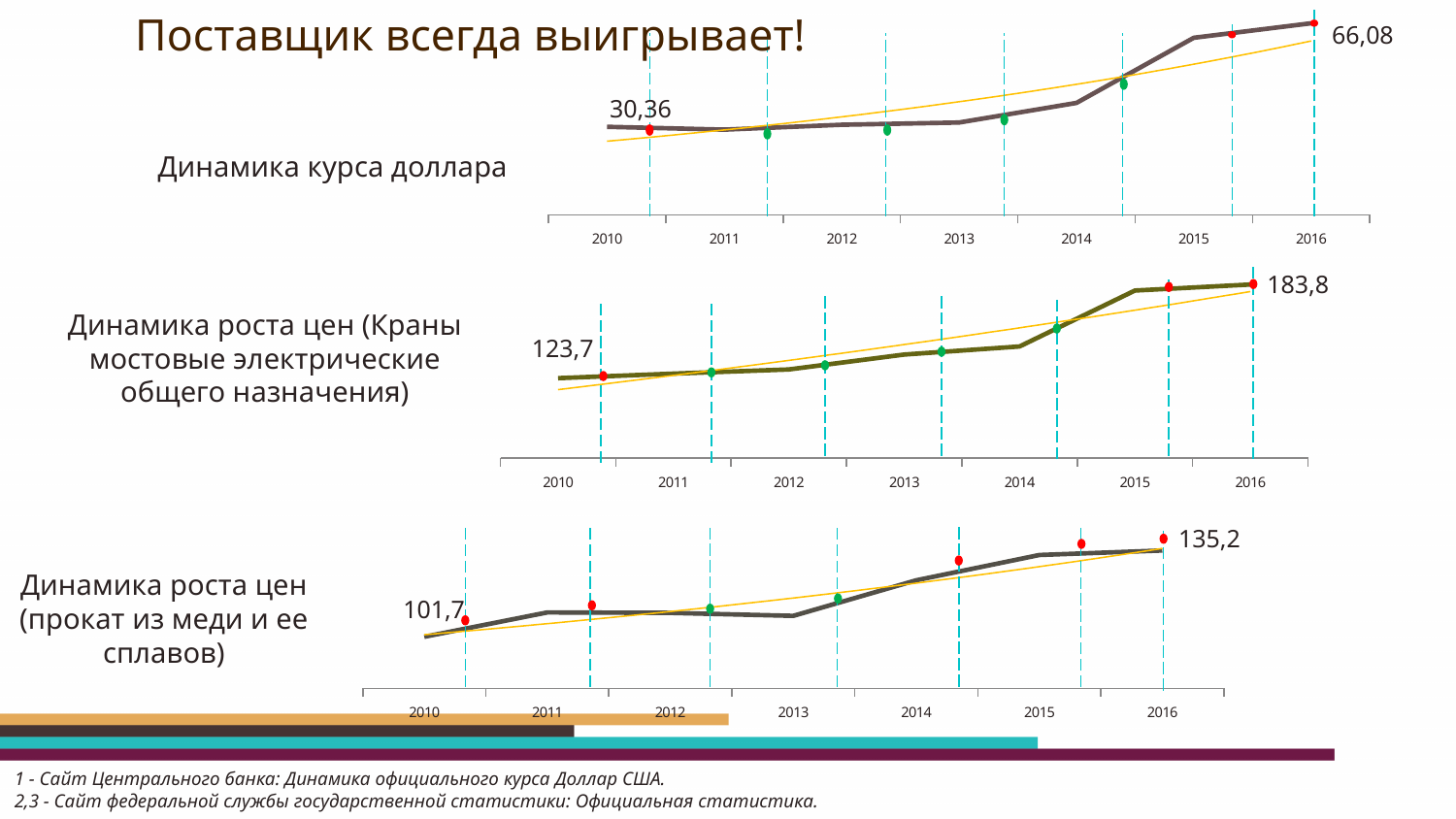
In the chart 'Динамика роста цен (прокат из меди и ее сплавов)', what value is labelled for 2016? 135,2 How many years are shown on the x axis of the chart 'Динамика роста цен (прокат из меди и ее сплавов)'? 7 In the chart 'Динамика роста цен (прокат из меди и ее сплавов)', what is the difference between the 2016 and 2010 values? 33,5 In the chart 'Динамика роста цен (Краны мостовые электрические общего назначения)', what value is labelled for 2010? 123,7 What kind of chart is 'Динамика курса доллара'? Line chart In the chart 'Динамика курса доллара', what value is labelled for 2010? 30,36 In the chart 'Динамика курса доллара', do the values rise or fall from 2010 to 2016? Rise In the chart 'Динамика курса доллара', by how much does the 2016 value exceed the 2010 value? 35,72 In the chart 'Динамика роста цен (Краны мостовые электрические общего назначения)', what is the difference between the 2016 and 2010 values? 60,1 In the chart 'Динамика роста цен (прокат из меди и ее сплавов)', what value is labelled for 2010? 101,7 In the chart 'Динамика курса доллара', what value is labelled for 2016? 66,08 In the chart 'Динамика роста цен (Краны мостовые электрические общего назначения)', what value is labelled for 2016? 183,8